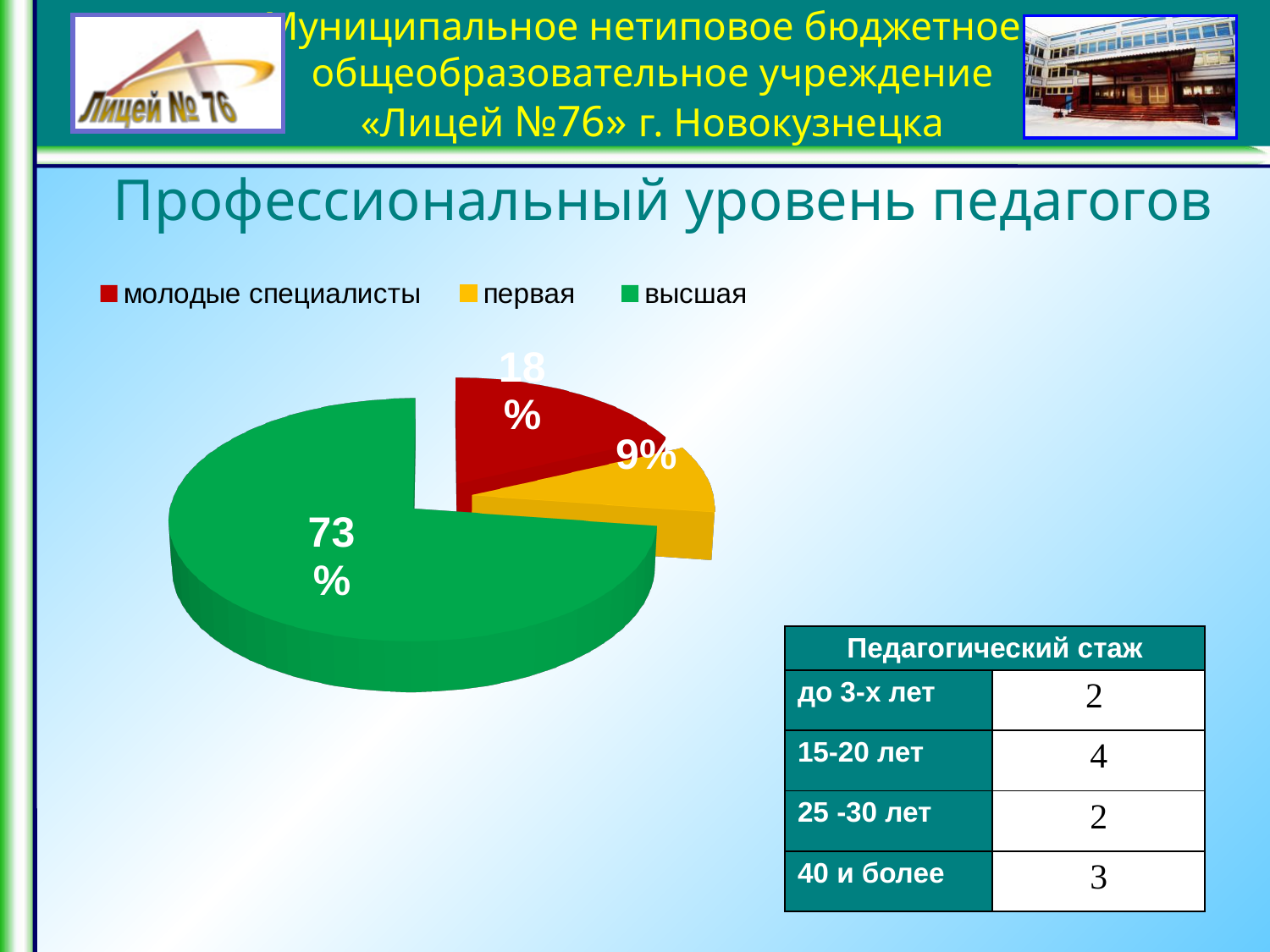
What share of the pie does the "молодые специалисты" slice represent? 18% What is the difference in percentage points between the "высшая" slice and the "молодые специалисты" slice? 55 What share of the pie does the "первая" slice represent? 9% How many entries does the chart legend list? 3 Which category has the smallest slice of the pie? первая What is the difference in percentage points between the "молодые специалисты" slice and the "первая" slice? 9 What colour is the "высшая" slice in the pie chart? green What share of the pie does the "высшая" slice represent? 73% Which category has the largest slice of the pie? высшая How many slices does the pie chart have? 3 What kind of chart is shown on the slide? pie chart Which slice is larger: "молодые специалисты" or "первая"? молодые специалисты